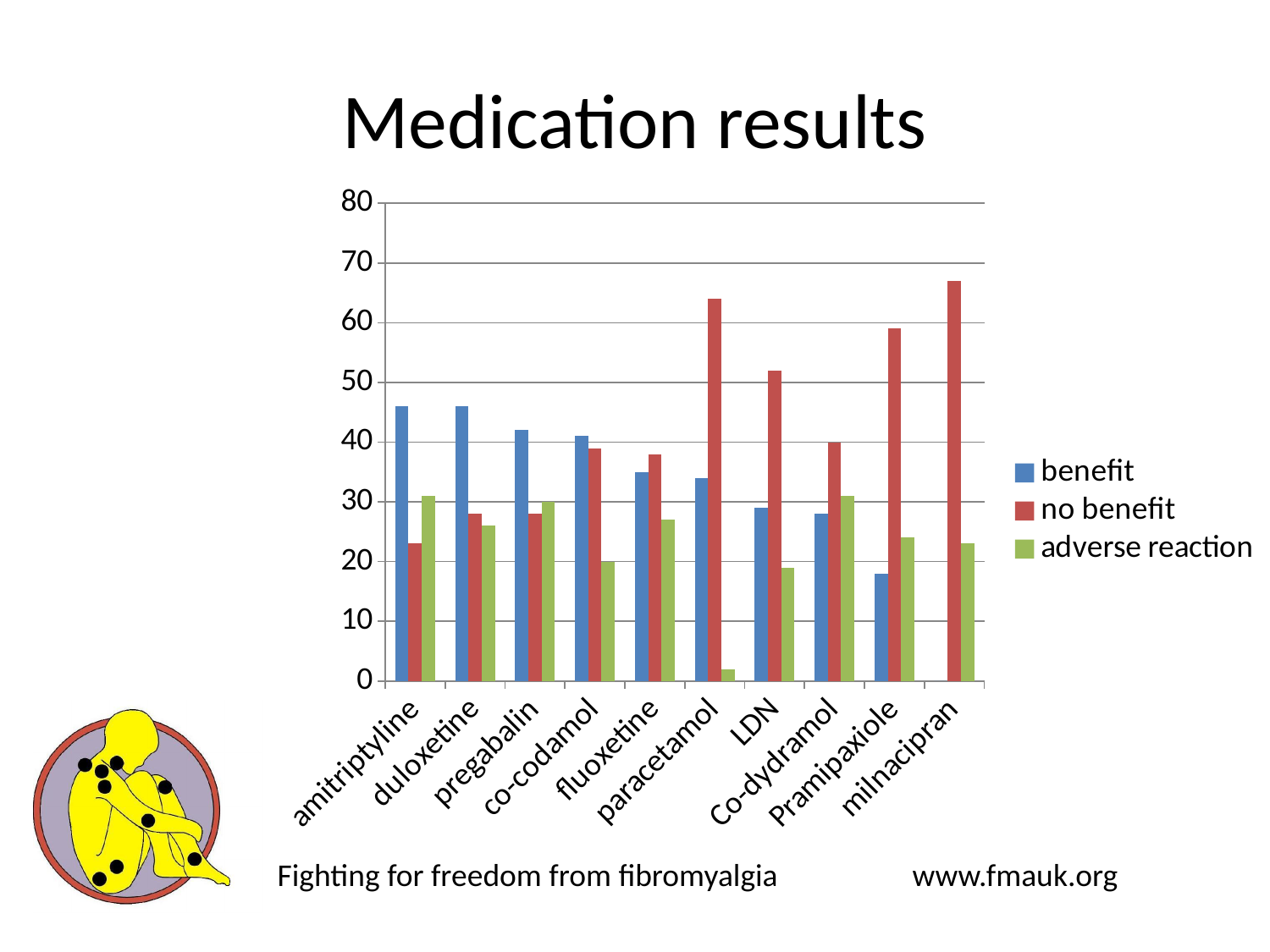
Do the benefit values generally rise or fall moving from left to right along the x axis? fall Which series is shown in green in the chart? adverse reaction How many medications are listed along the x axis of the chart? 10 What is the title of the chart? Medication results How many series does the chart legend list? 3 Which medication has the lowest adverse reaction value? paracetamol Is the benefit value for Pramipaxiole greater or less than 20? less For paracetamol, which is larger: the benefit value or the no benefit value? no benefit Is the benefit value for amitriptyline greater or less than 40? greater Is the no benefit value for LDN greater or less than 50? greater What kind of chart is shown on the slide? bar chart